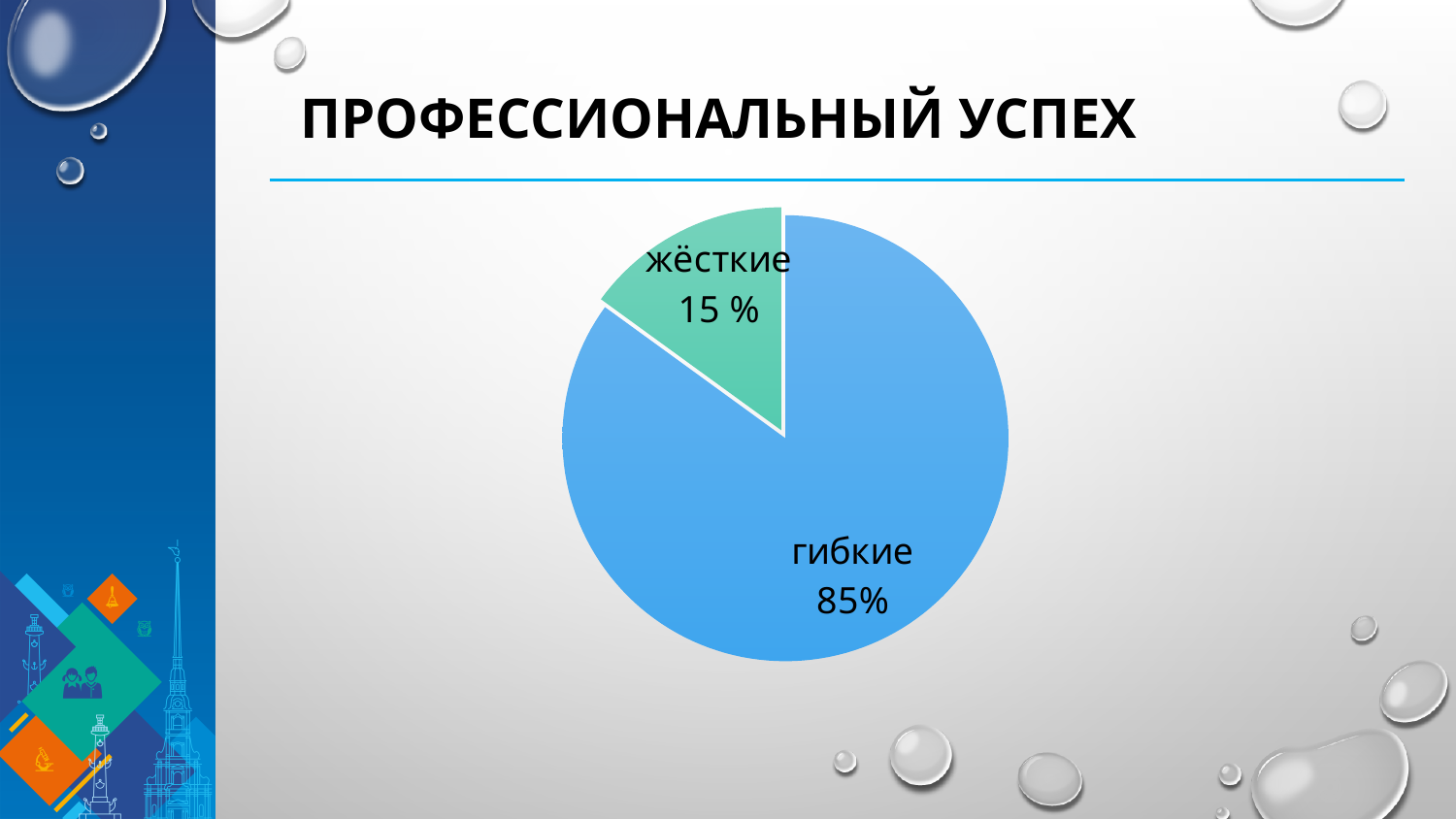
What share of the pie is labelled "гибкие"? 85% Which slice of the pie is the smallest? жёсткие What is the title of the slide containing the pie chart? ПРОФЕССИОНАЛЬНЫЙ УСПЕХ Which slice of the pie is the largest? гибкие What colour is the "жёсткие" slice of the pie? green What share of the pie is labelled "жёсткие"? 15 % Which slice is larger, "гибкие" or "жёсткие"? гибкие What kind of chart is shown on the slide? pie chart How many slices does the pie chart have? 2 What is the difference in percentage points between the "гибкие" and "жёсткие" slices? 70